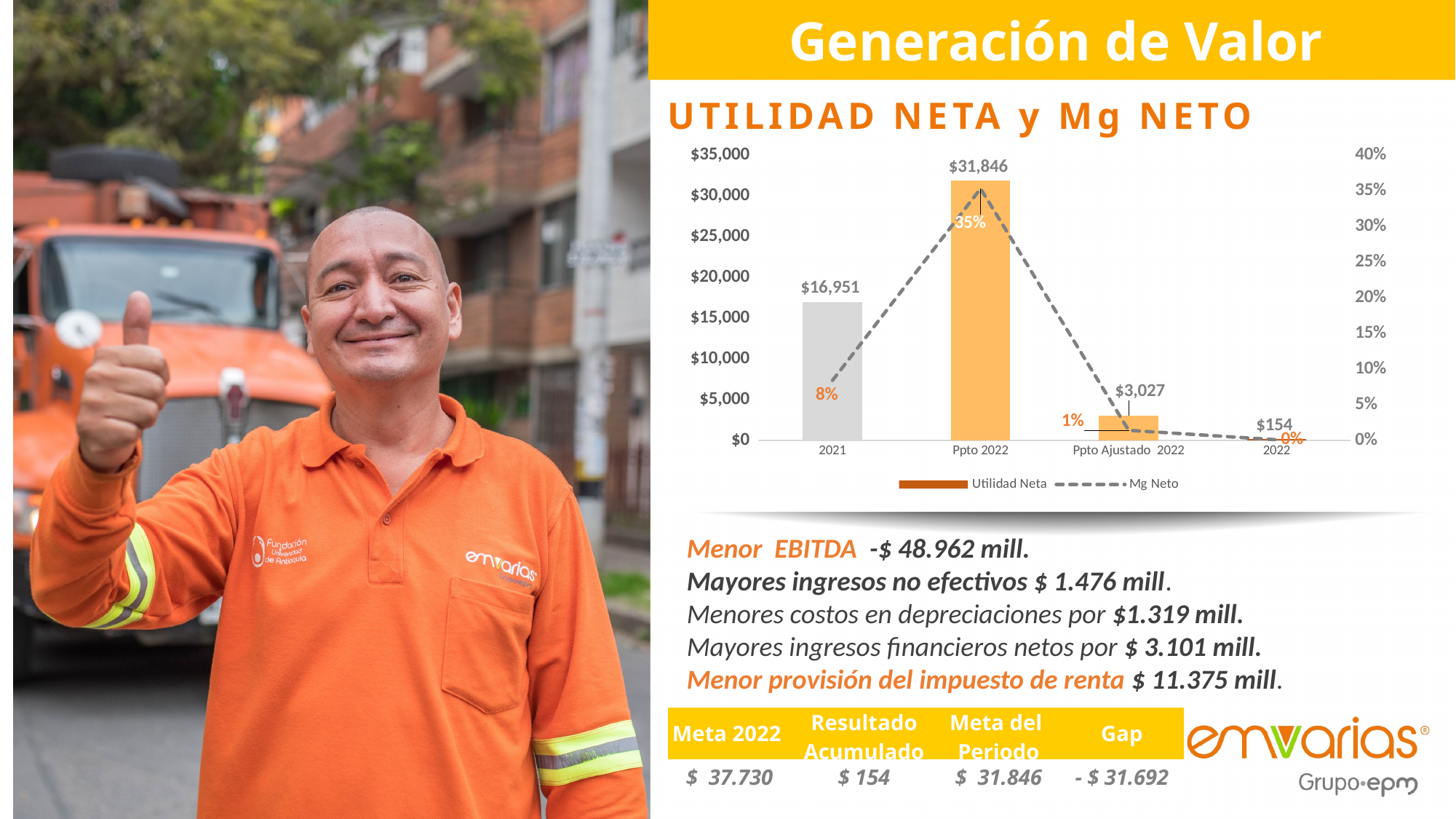
Which is larger, the Mg Neto for 2021 or for Ppto Ajustado 2022? 2021 Which category has the lowest Utilidad Neta? 2022 What kind of chart is used to show Utilidad Neta? Bar chart What is the title of the chart? UTILIDAD NETA y Mg NETO Which category has the highest Utilidad Neta? Ppto 2022 What is the Utilidad Neta value for 2022? $154 How many categories are shown on the x axis of the chart? 4 What is the Utilidad Neta value for 2021? $16,951 How many series does the chart legend list? 2 What is the difference in Utilidad Neta between Ppto 2022 and Ppto Ajustado 2022? $28,819 What is the Utilidad Neta value for Ppto 2022? $31,846 What is the Mg Neto value for Ppto 2022? 35%